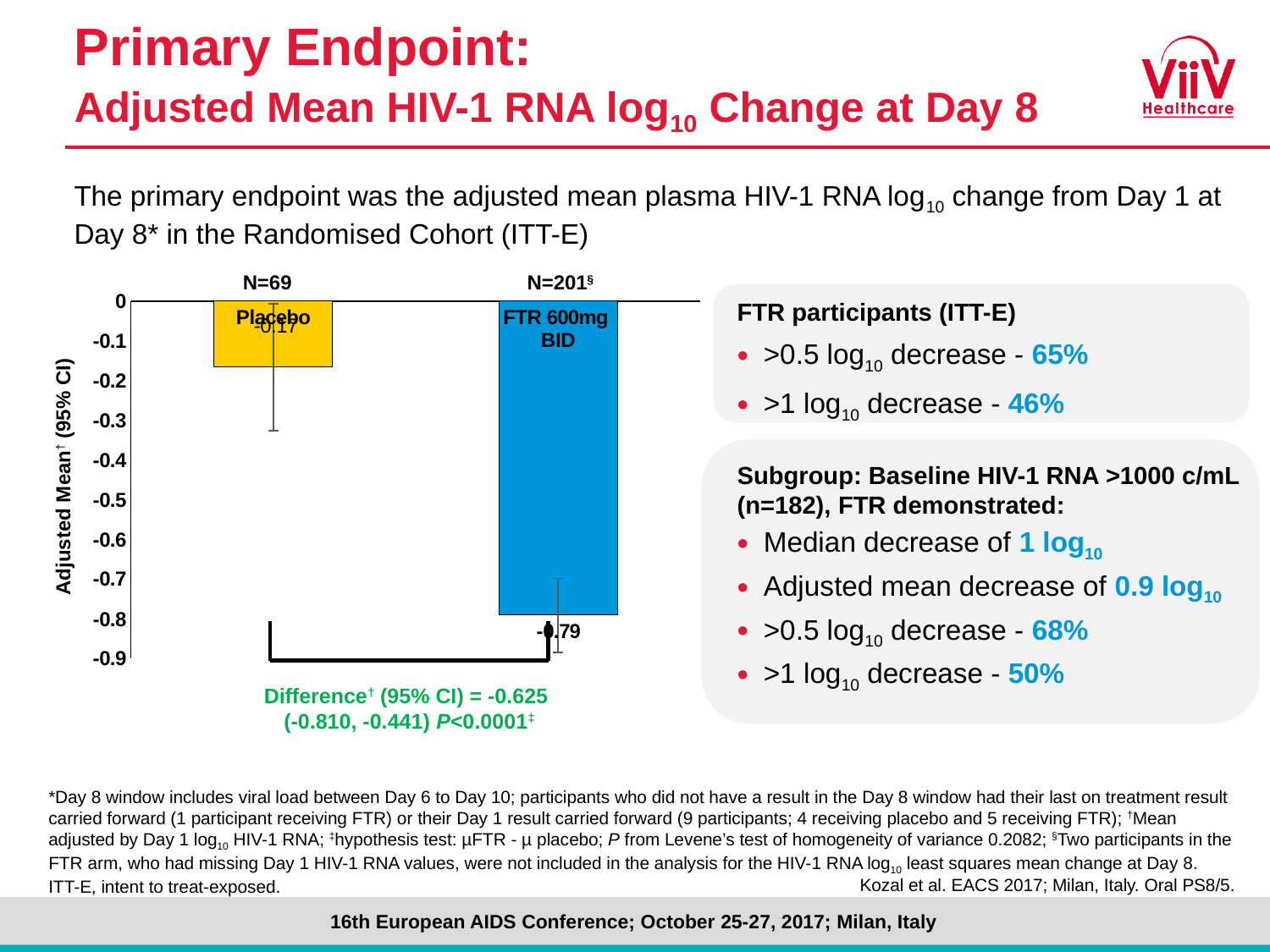
What type of chart is used to show the adjusted mean HIV-1 RNA change? Bar chart Which arm shows the larger decrease in HIV-1 RNA log10 at Day 8? FTR 600mg BID How many bars are plotted in the chart? 2 Which bar has the value closest to zero? Placebo What is the adjusted mean HIV-1 RNA log10 change at Day 8 for the FTR 600mg BID arm? -0.79 What is the difference between the FTR 600mg BID and Placebo adjusted mean values shown as data labels? 0.62 Is the adjusted mean value for the Placebo arm greater or less than -0.3? greater Is the adjusted mean value for the FTR 600mg BID arm greater or less than -0.5? less Which bar has the lowest (most negative) adjusted mean value? FTR 600mg BID What is the N for the FTR 600mg BID arm shown above its bar? N=201 What is the adjusted mean HIV-1 RNA log10 change at Day 8 for the Placebo arm? -0.17 What is the y-axis label of the chart? Adjusted Mean† (95% CI)